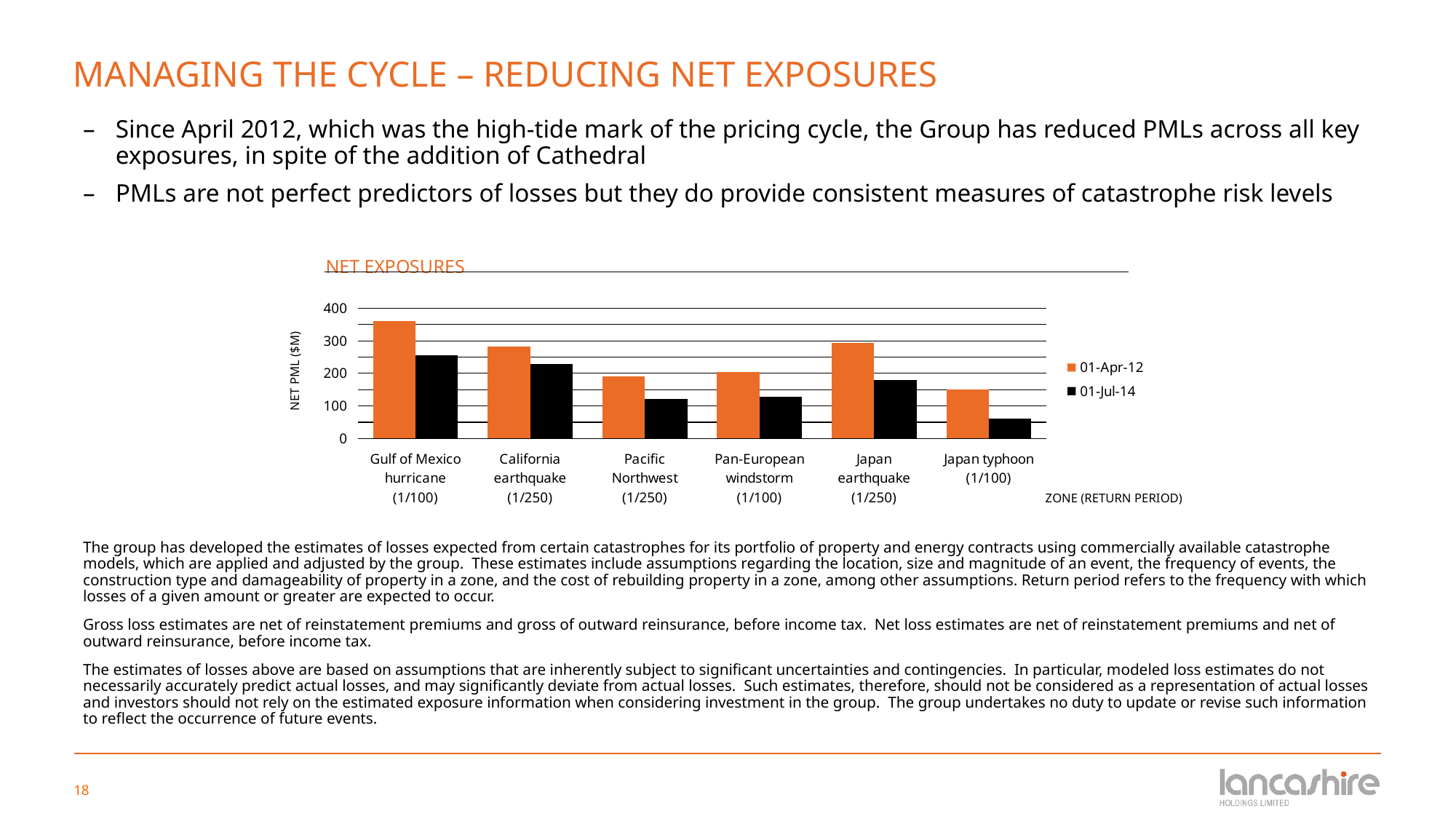
Is the 01-Apr-12 value for Gulf of Mexico hurricane greater or less than 300? greater Which zone has the lowest 01-Apr-12 net PML? Japan typhoon (1/100) Is the 01-Jul-14 value for Japan typhoon greater or less than 100? less What is the label on the vertical axis of the chart? NET PML ($M) For Japan earthquake, which series has the larger value, 01-Apr-12 or 01-Jul-14? 01-Apr-12 How many series does the chart's legend list? 2 What kind of chart is shown on the slide? bar chart Which zone has the highest 01-Apr-12 net PML? Gulf of Mexico hurricane (1/100) Is the 01-Jul-14 value for Pacific Northwest greater or less than 200? less Which zone has the lowest 01-Jul-14 net PML? Japan typhoon (1/100) How many zones (categories) are shown on the x axis of the chart? 6 Which is larger: the 01-Apr-12 value for California earthquake or the 01-Apr-12 value for Pacific Northwest? California earthquake